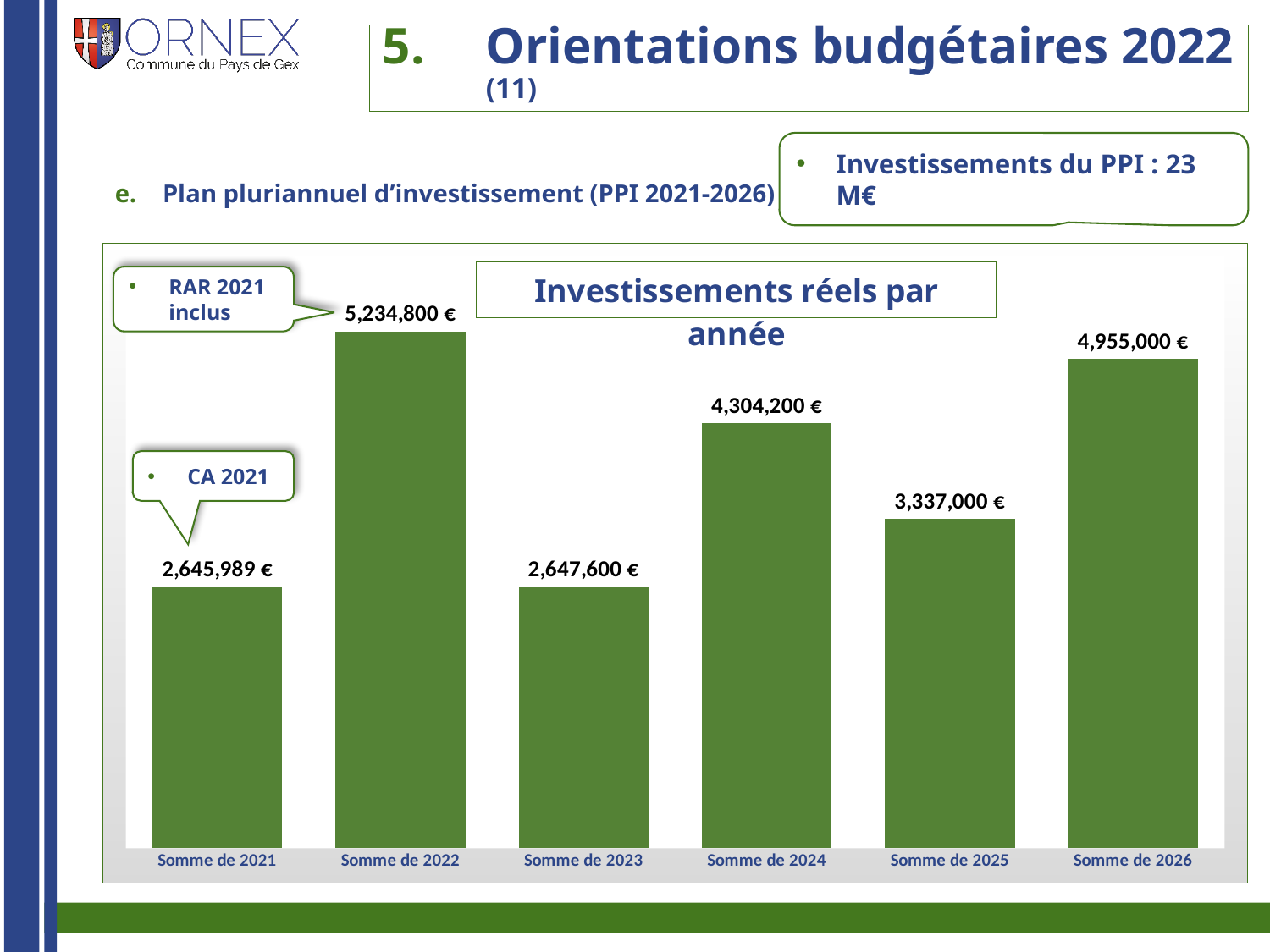
What is the value for Somme de 2022? 5,234,800 € Which is larger, the value for Somme de 2026 or the value for Somme de 2023? Somme de 2026 What is the value for Somme de 2024? 4,304,200 € What kind of chart is shown on the slide? Bar chart What is the value for Somme de 2026? 4,955,000 € How many categories are shown in the chart? 6 What is the difference between the values for Somme de 2022 and Somme de 2021? 2,588,811 € What is the difference between the values for Somme de 2026 and Somme de 2025? 1,618,000 € What is the title of the chart? Investissements réels par année Which category has the highest value? Somme de 2022 What is the value for Somme de 2025? 3,337,000 € Which is larger, the value for Somme de 2024 or the value for Somme de 2025? Somme de 2024